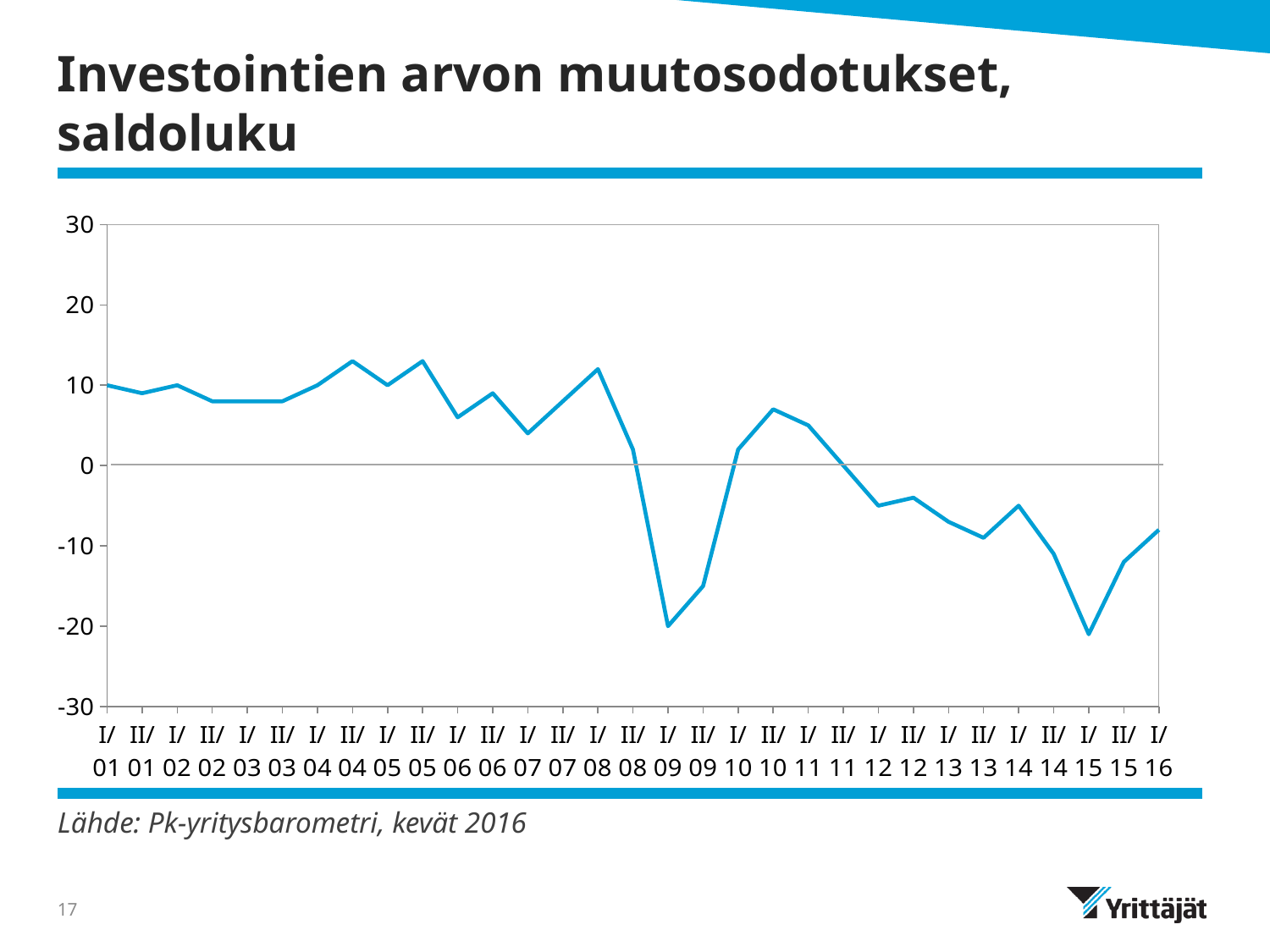
Which has the larger value, I/01 or I/09? I/01 Is the value for I/12 greater or less than 0? less Is the value for I/09 greater or less than -10? less What is the title of the chart on the slide? Investointien arvon muutosodotukset, saldoluku Is the value for II/10 greater or less than 0? greater Which has the larger value, II/04 or I/07? II/04 Do the values rise or fall from I/11 to I/13? fall What kind of chart is shown on the slide? line chart How many data points are plotted on the line, from I/01 to I/16? 31